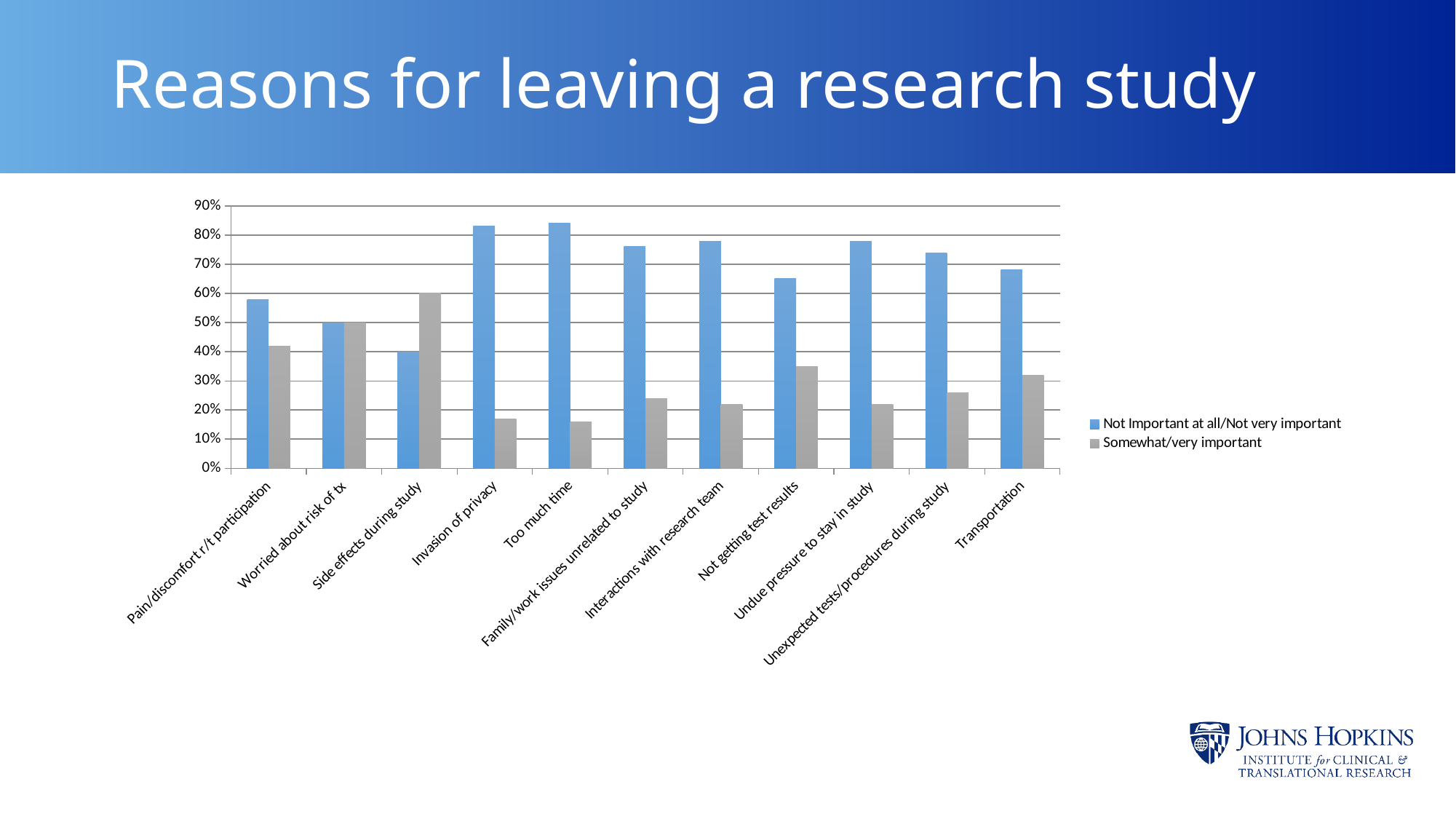
How many reasons (categories) are shown along the x axis? 11 What kind of chart is shown on the slide? bar chart What is the 'Somewhat/very important' value for 'Side effects during study'? 60% Which category has the lowest 'Not Important at all/Not very important' value? Side effects during study Is the 'Somewhat/very important' value for 'Not getting test results' greater or less than 30%? greater How many series does the legend list? 2 Which category has the highest 'Somewhat/very important' value? Side effects during study What is the 'Not Important at all/Not very important' value for 'Side effects during study'? 40% For 'Pain/discomfort r/t participation', which series has the larger value? Not Important at all/Not very important What is the title of the slide? Reasons for leaving a research study Is the 'Not Important at all/Not very important' value for 'Invasion of privacy' greater or less than 80%? greater What is the 'Not Important at all/Not very important' value for 'Worried about risk of tx'? 50%